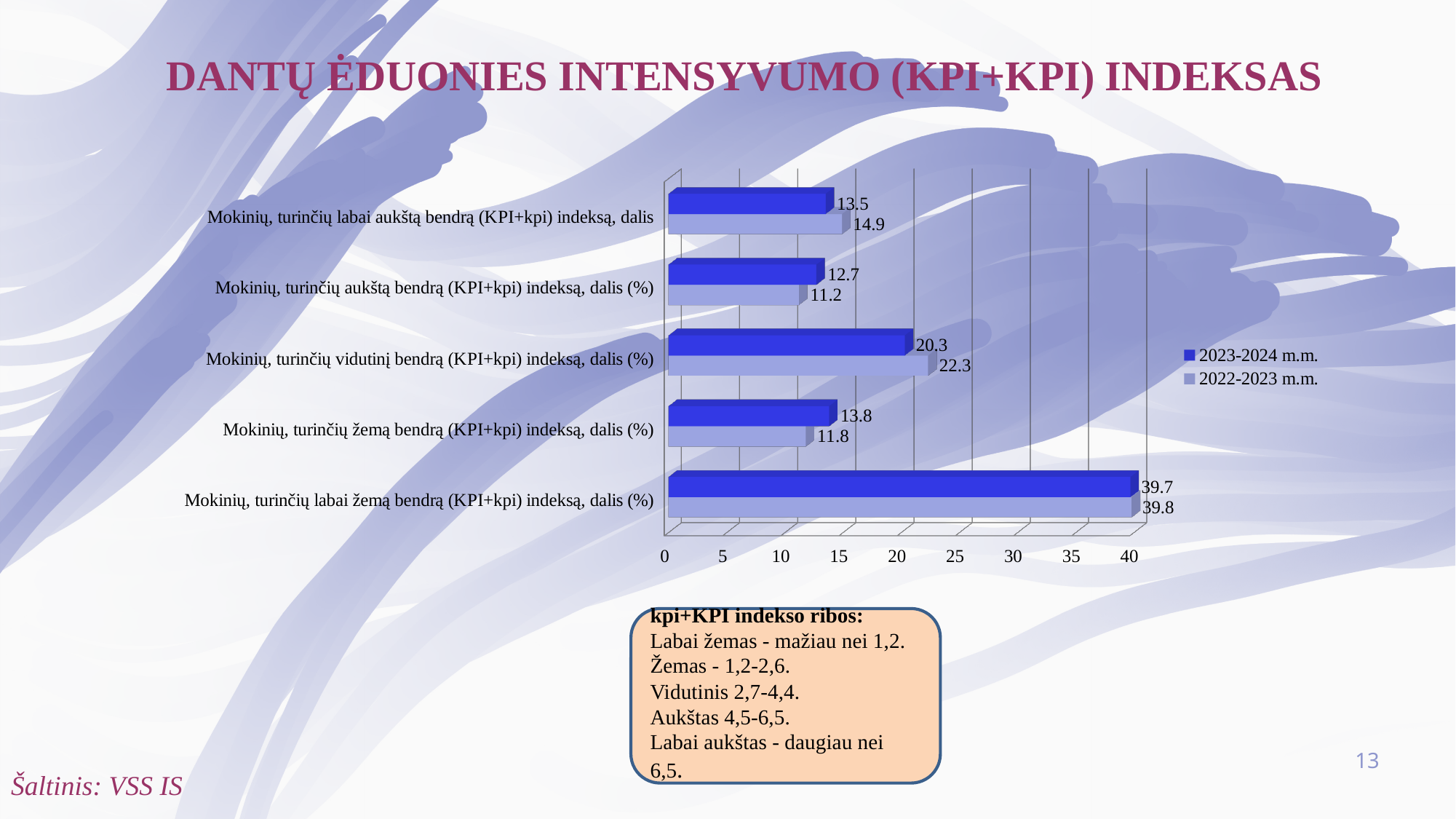
How many categories are plotted in the chart? 5 For 'Mokinių, turinčių vidutinį bendrą (KPI+kpi) indeksą, dalis (%)', which series has the larger value, 2023-2024 m.m. or 2022-2023 m.m.? 2022-2023 m.m. What is the 2023-2024 m.m. value for 'Mokinių, turinčių labai žemą bendrą (KPI+kpi) indeksą, dalis (%)'? 39.7 What is the 2023-2024 m.m. value for 'Mokinių, turinčių aukštą bendrą (KPI+kpi) indeksą, dalis (%)'? 12.7 Which category has the lowest 2022-2023 m.m. value? Mokinių, turinčių aukštą bendrą (KPI+kpi) indeksą, dalis (%) What is the 2022-2023 m.m. value for 'Mokinių, turinčių labai aukštą bendrą (KPI+kpi) indeksą, dalis'? 14.9 What is the 2022-2023 m.m. value for 'Mokinių, turinčių vidutinį bendrą (KPI+kpi) indeksą, dalis (%)'? 22.3 What is the title of the slide containing the chart? DANTŲ ĖDUONIES INTENSYVUMO (KPI+KPI) INDEKSAS Which category has the highest 2023-2024 m.m. value? Mokinių, turinčių labai žemą bendrą (KPI+kpi) indeksą, dalis (%) How many series does the legend list? 2 What kind of chart is shown on the slide? bar chart What is the difference between the 2022-2023 m.m. and 2023-2024 m.m. values for 'Mokinių, turinčių žemą bendrą (KPI+kpi) indeksą, dalis (%)'? 2.0